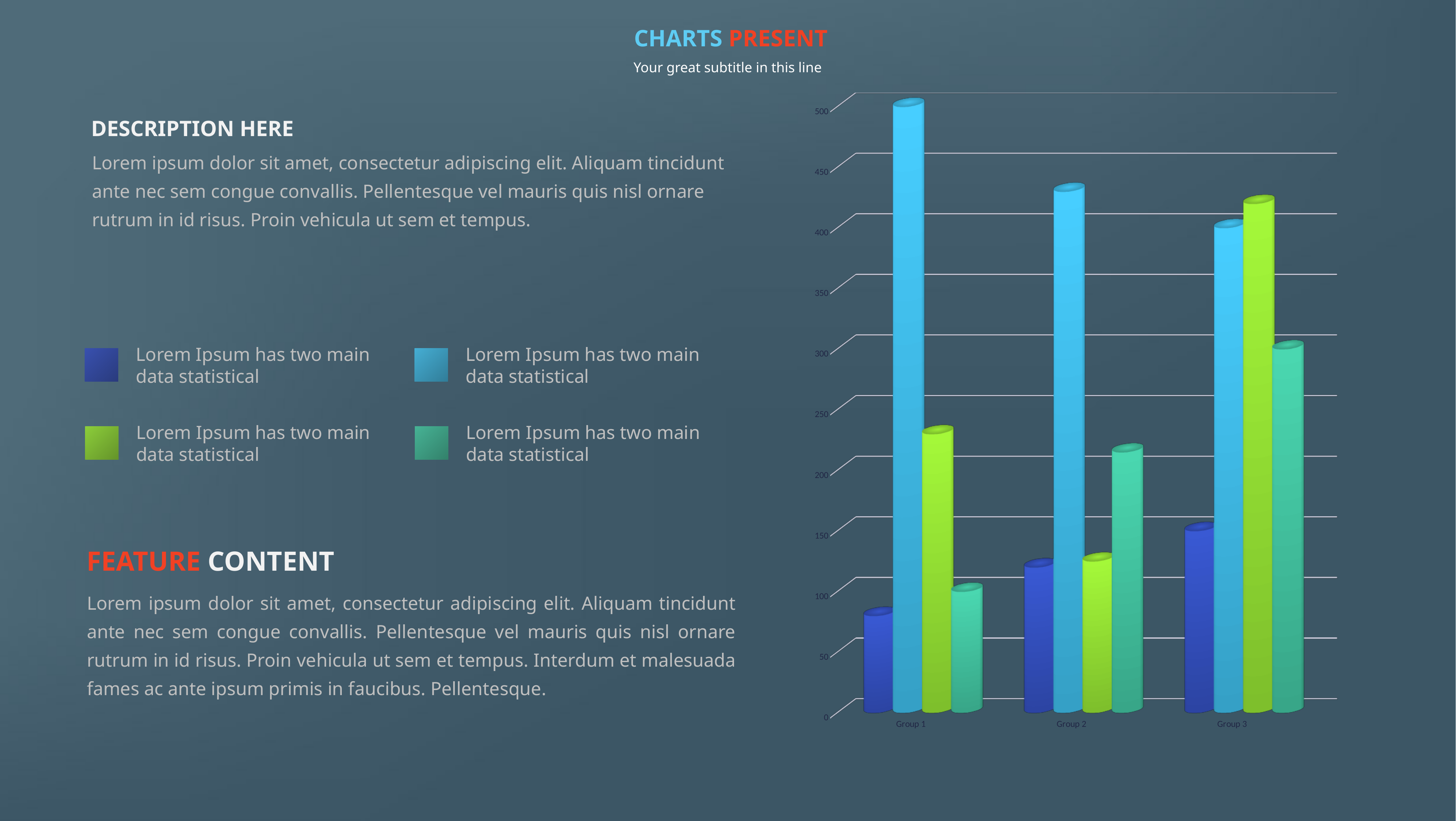
Is the value of the teal bar for Group 3 greater or less than 250? greater Which bar is the tallest in Group 1? the light blue bar How many groups are shown on the x axis of the chart? 3 Is the value of the light blue bar for Group 2 greater or less than 400? greater Is the value of the dark blue bar for Group 1 greater or less than 100? less Which bar is the shortest in Group 1? the dark blue bar What kind of chart is shown on the slide? bar chart What is the title shown above the chart on the slide? CHARTS PRESENT Is the light blue bar larger for Group 1 or for Group 2? Group 1 Do the values of the light blue bars rise or fall from Group 1 to Group 3? fall How many bars are plotted for each group in the chart? 4